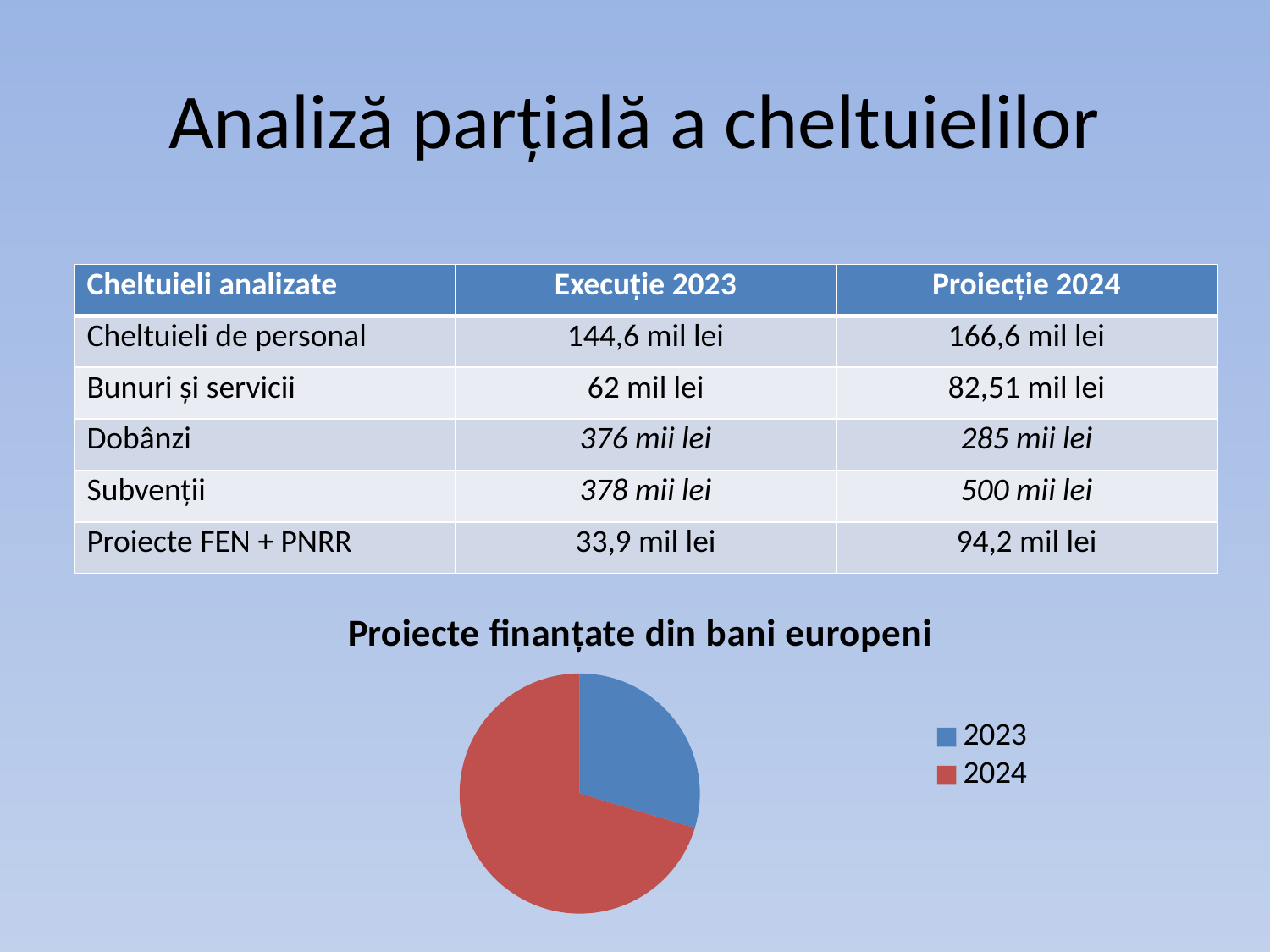
What is the title of the pie chart on the slide? Proiecte finanțate din bani europeni In the pie chart "Proiecte finanțate din bani europeni", which year has the larger slice? 2024 In the pie chart "Proiecte finanțate din bani europeni", which year has the smaller slice? 2023 What kind of chart is shown under the heading "Proiecte finanțate din bani europeni"? pie chart How many entries does the legend of the pie chart list? 2 Which colour represents 2024 in the pie chart? red How many slices does the pie chart "Proiecte finanțate din bani europeni" have? 2 In the pie chart, is the slice for 2023 larger or smaller than the slice for 2024? smaller